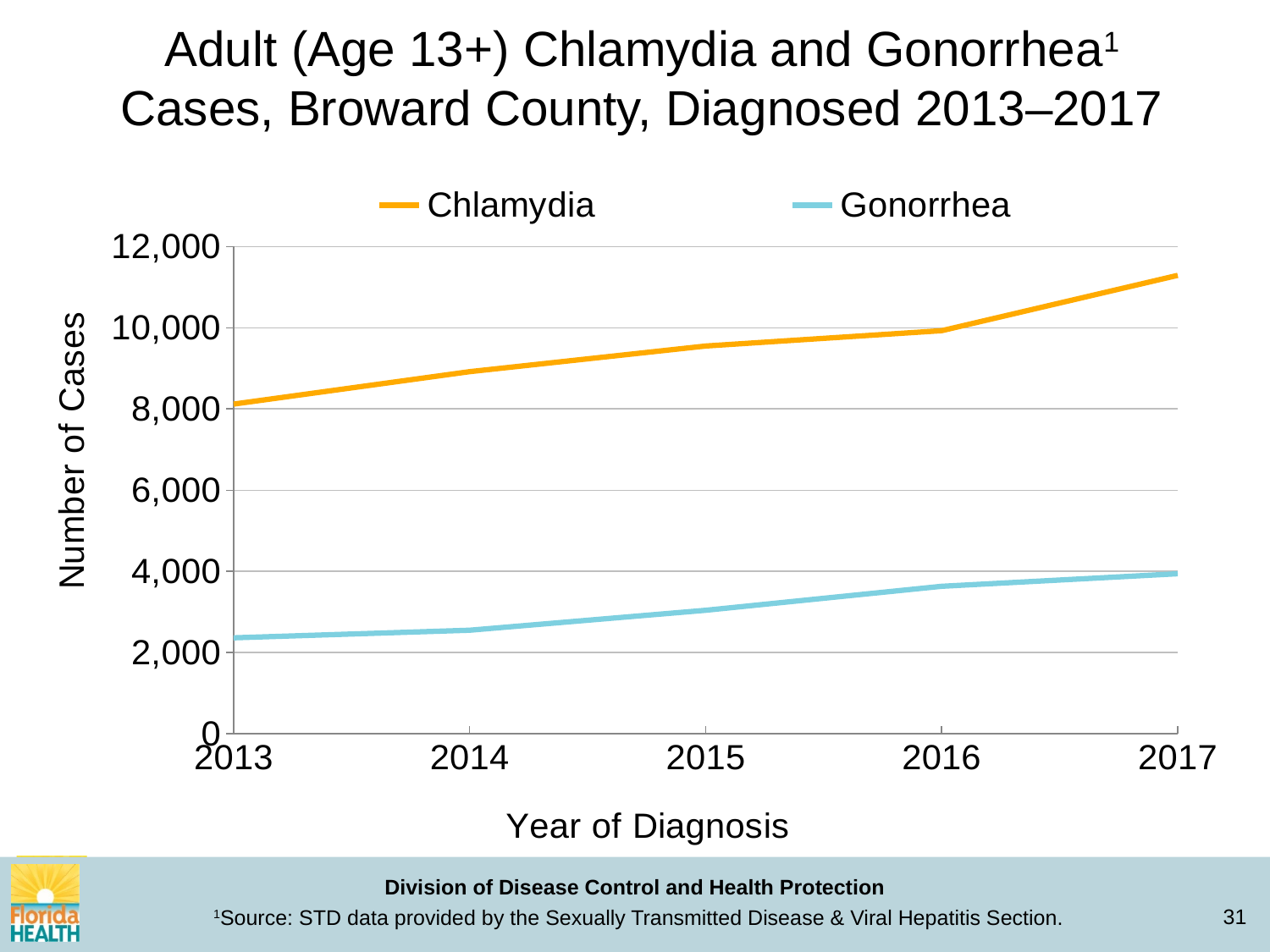
Is the number of Chlamydia cases in 2017 greater or less than 10,000? greater Do Gonorrhea cases rise or fall from 2013 to 2017? rise In 2017, which series has more cases, Chlamydia or Gonorrhea? Chlamydia Is the number of Gonorrhea cases in 2015 greater or less than 4,000? less Do Chlamydia cases rise or fall from 2013 to 2017? rise What is the title of the y axis? Number of Cases In which year is the number of Chlamydia cases highest? 2017 How many series does the legend list? 2 What kind of chart is shown on the slide? line chart Is the number of Chlamydia cases in 2015 greater or less than 10,000? less In which year is the number of Gonorrhea cases lowest? 2013 How many years are plotted along the x axis? 5